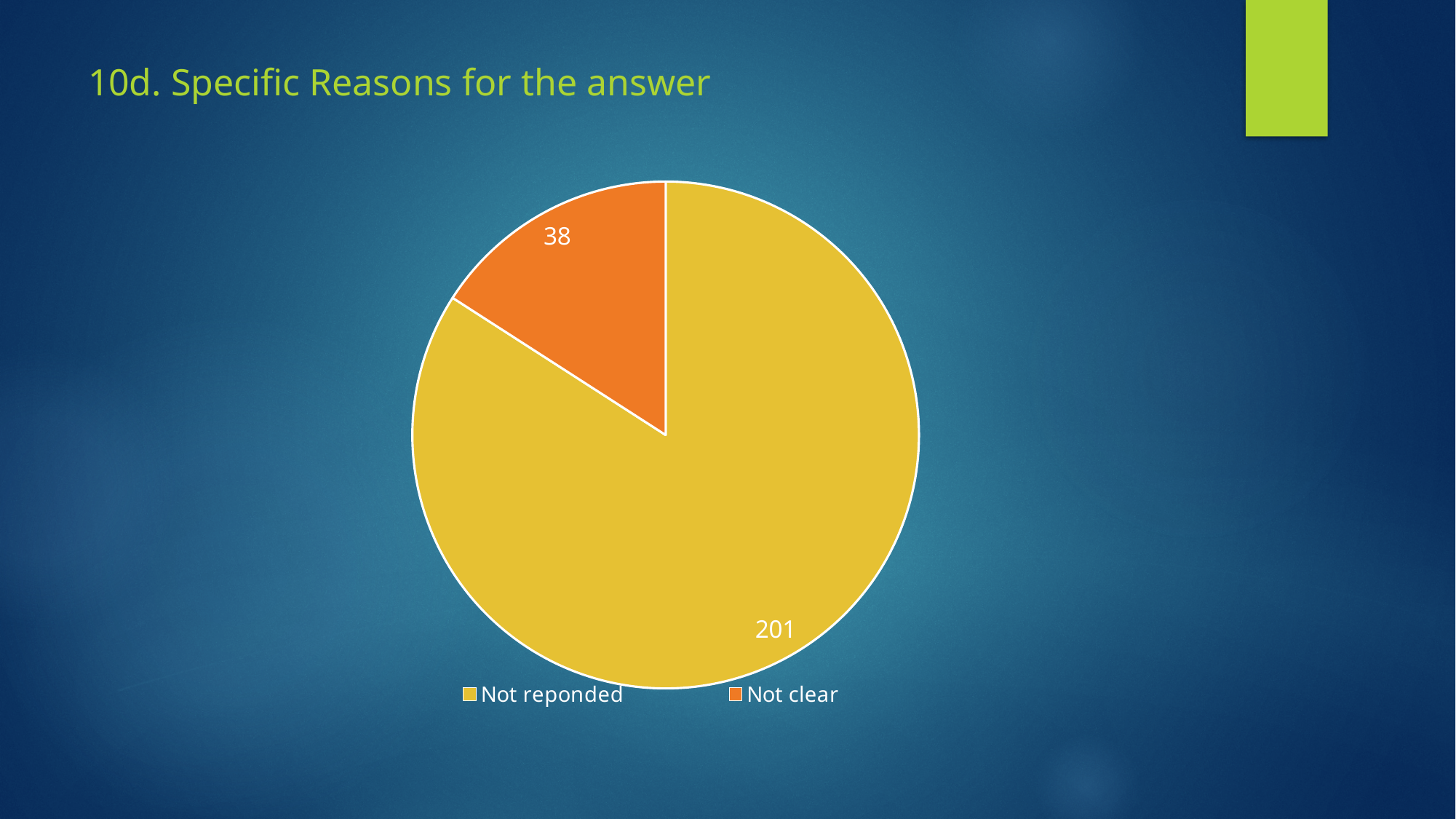
What is the title of the slide? 10d. Specific Reasons for the answer Which category has the smallest slice? Not clear What is the value for Not clear? 38 How many entries does the legend list? 2 What is the difference between the values for Not reponded and Not clear? 163 How many slices does the pie chart have? 2 What is the total of all slices in the pie chart? 239 Which category has the largest slice? Not reponded What is the value for Not reponded? 201 What kind of chart is shown on the slide? pie chart Which is larger, Not reponded or Not clear? Not reponded What colour is the Not clear slice? orange